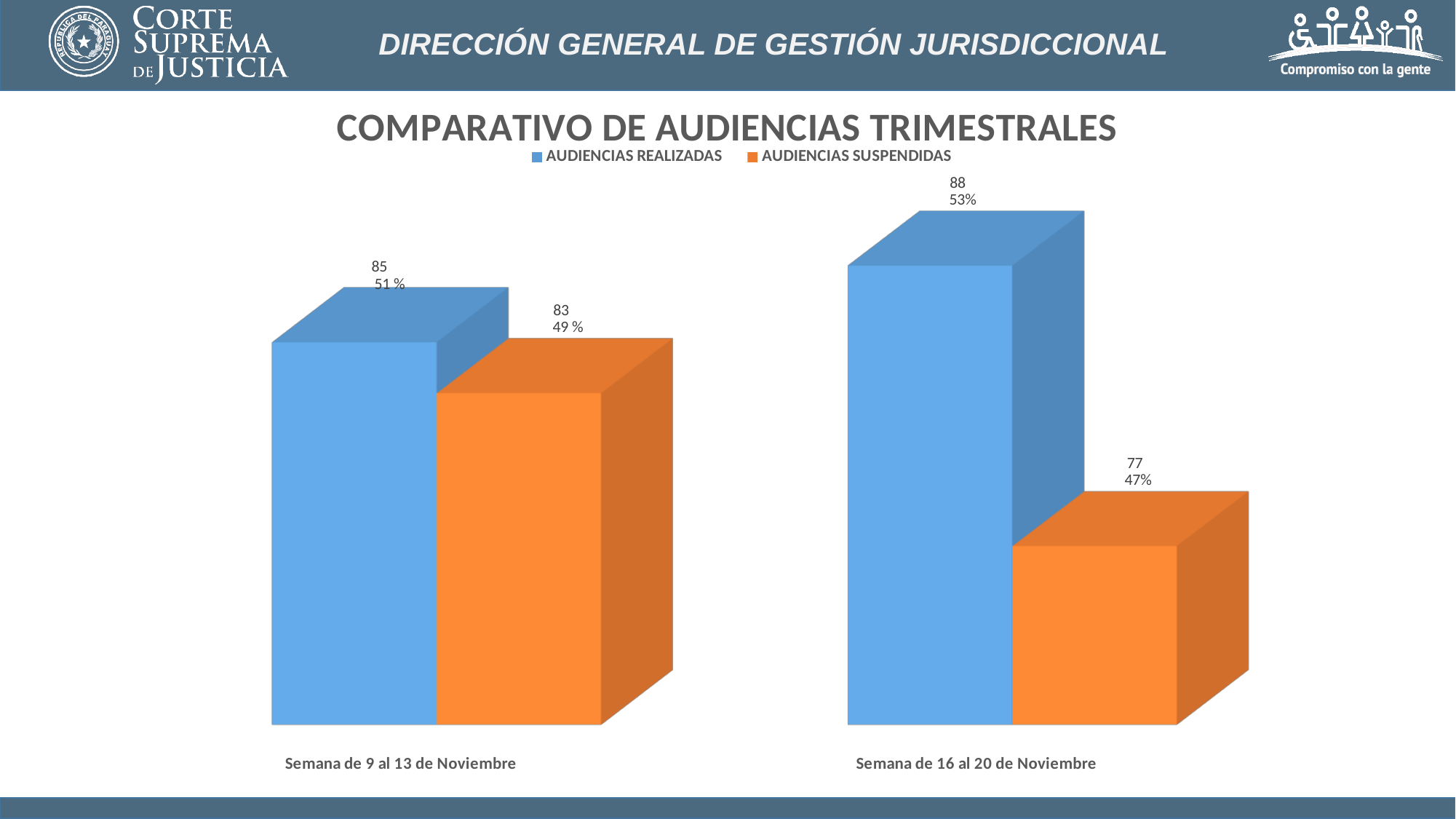
Which week has the lower value for AUDIENCIAS SUSPENDIDAS? Semana de 16 al 20 de Noviembre What is the value of AUDIENCIAS SUSPENDIDAS for Semana de 16 al 20 de Noviembre? 77 What is the value of AUDIENCIAS SUSPENDIDAS for Semana de 9 al 13 de Noviembre? 83 How many categories (weeks) are shown on the x axis? 2 How many series does the legend list? 2 What is the value of AUDIENCIAS REALIZADAS for Semana de 9 al 13 de Noviembre? 85 What type of chart is shown on the slide? Bar chart What percentage is shown for AUDIENCIAS REALIZADAS in Semana de 16 al 20 de Noviembre? 53% Is AUDIENCIAS REALIZADAS or AUDIENCIAS SUSPENDIDAS larger for Semana de 16 al 20 de Noviembre? AUDIENCIAS REALIZADAS What is the difference between AUDIENCIAS REALIZADAS and AUDIENCIAS SUSPENDIDAS for Semana de 9 al 13 de Noviembre? 2 Which week has the higher value for AUDIENCIAS REALIZADAS? Semana de 16 al 20 de Noviembre What is the difference between AUDIENCIAS REALIZADAS and AUDIENCIAS SUSPENDIDAS for Semana de 16 al 20 de Noviembre? 11